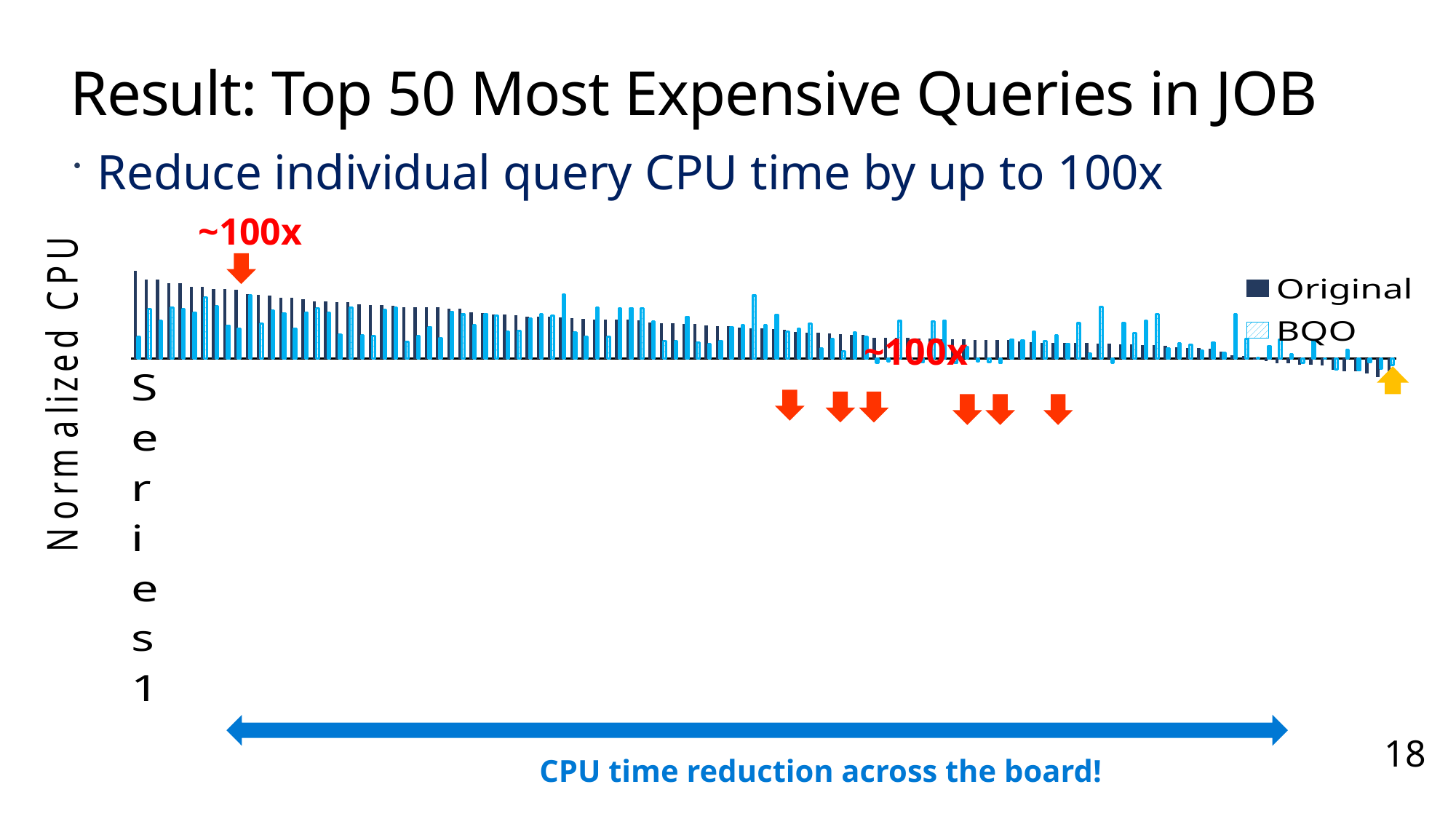
How many series does the chart's legend list? 2 For the leftmost query, which series has the taller bar, Original or BQO? Original What kind of chart is shown on the slide? bar chart Do the Original bars generally rise or fall from left to right along the x axis? fall What are the two series named in the chart's legend? Original and BQO Which series is drawn in dark navy bars? Original Which series contains the tallest bar in the chart? Original What is the label on the chart's vertical axis? Normalized CPU